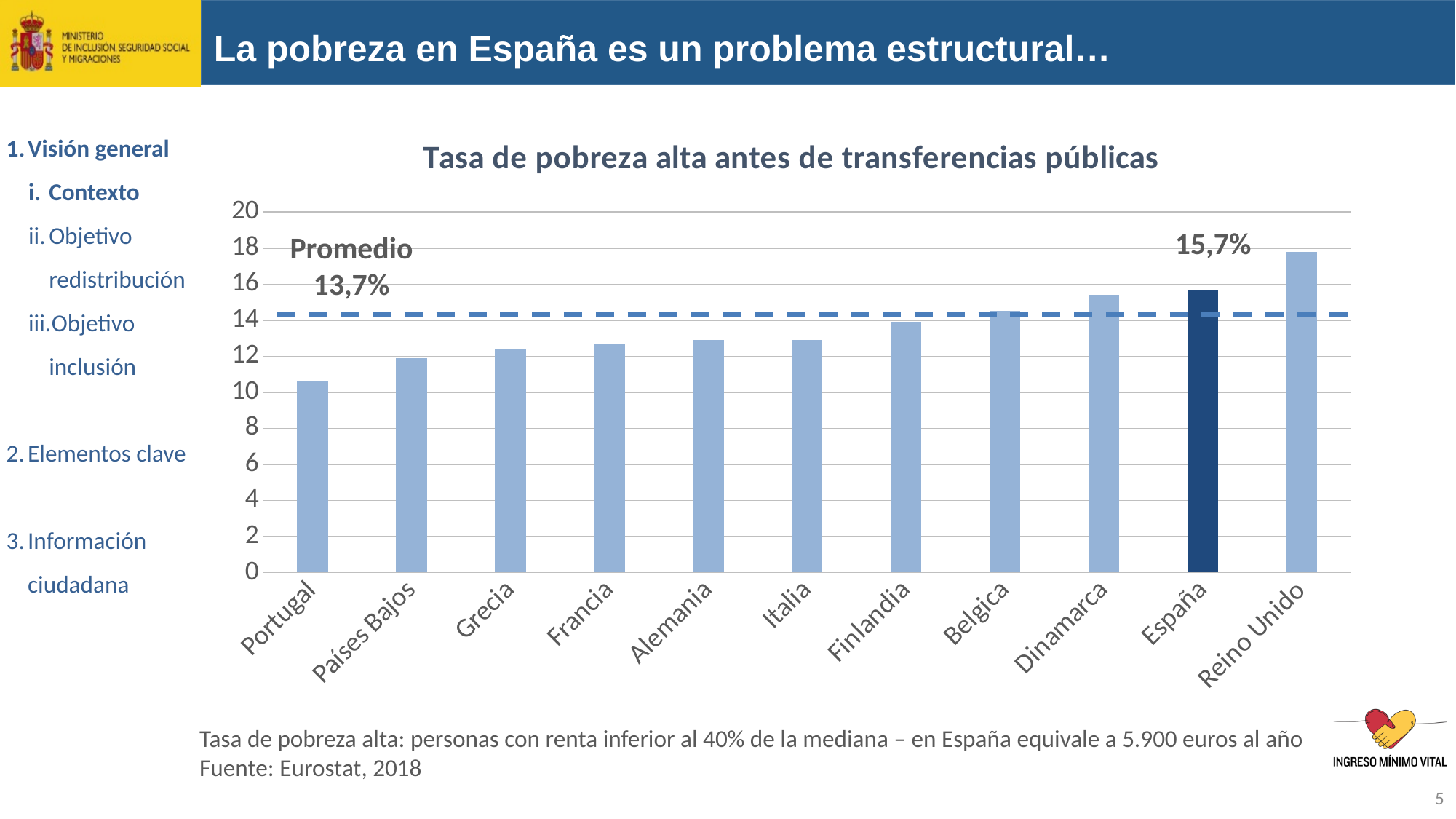
Is the value for Grecia greater or less than 14? less What is the title of the chart? Tasa de pobreza alta antes de transferencias públicas How many countries are shown on the x axis? 11 Is the value for Reino Unido greater or less than 16? greater Which country has the lowest bar in the chart? Portugal Do the bar values rise or fall from left to right along the x axis? Rise Which country has the highest bar in the chart? Reino Unido Is the value for Portugal greater or less than 12? less What is the value shown for España? 15,7% Which is larger, the value for Reino Unido or the value for España? Reino Unido What is the value of the Promedio (average) line shown in the chart? 13,7% What kind of chart is shown on the slide? Bar chart